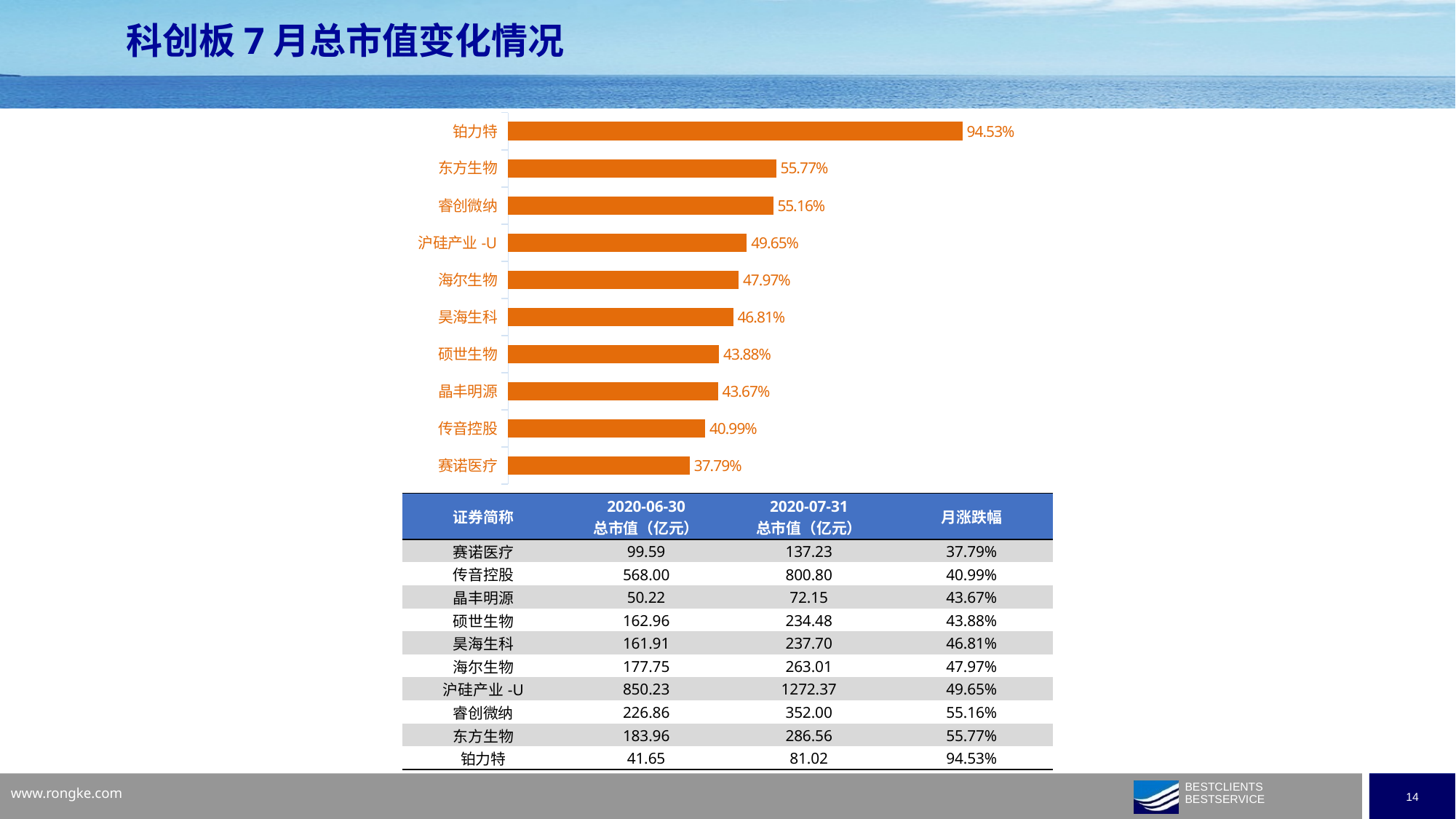
What is the value shown for 传音控股 in the bar chart? 40.99% Which category has the highest value in the bar chart? 铂力特 How many categories are shown in the bar chart? 10 Which category has the lowest value in the bar chart? 赛诺医疗 What is the value shown for 铂力特 in the bar chart? 94.53% Which has a larger value in the bar chart, 硕世生物 or 传音控股? 硕世生物 Which has a larger value in the bar chart, 东方生物 or 睿创微纳? 东方生物 What is the difference between the values for 沪硅产业 -U and 海尔生物 in the bar chart? 1.68% What is the value shown for 海尔生物 in the bar chart? 47.97% What colour are the bars in the chart? Orange What type of chart is shown on the slide? Bar chart What is the difference between the values for 铂力特 and 赛诺医疗 in the bar chart? 56.74%